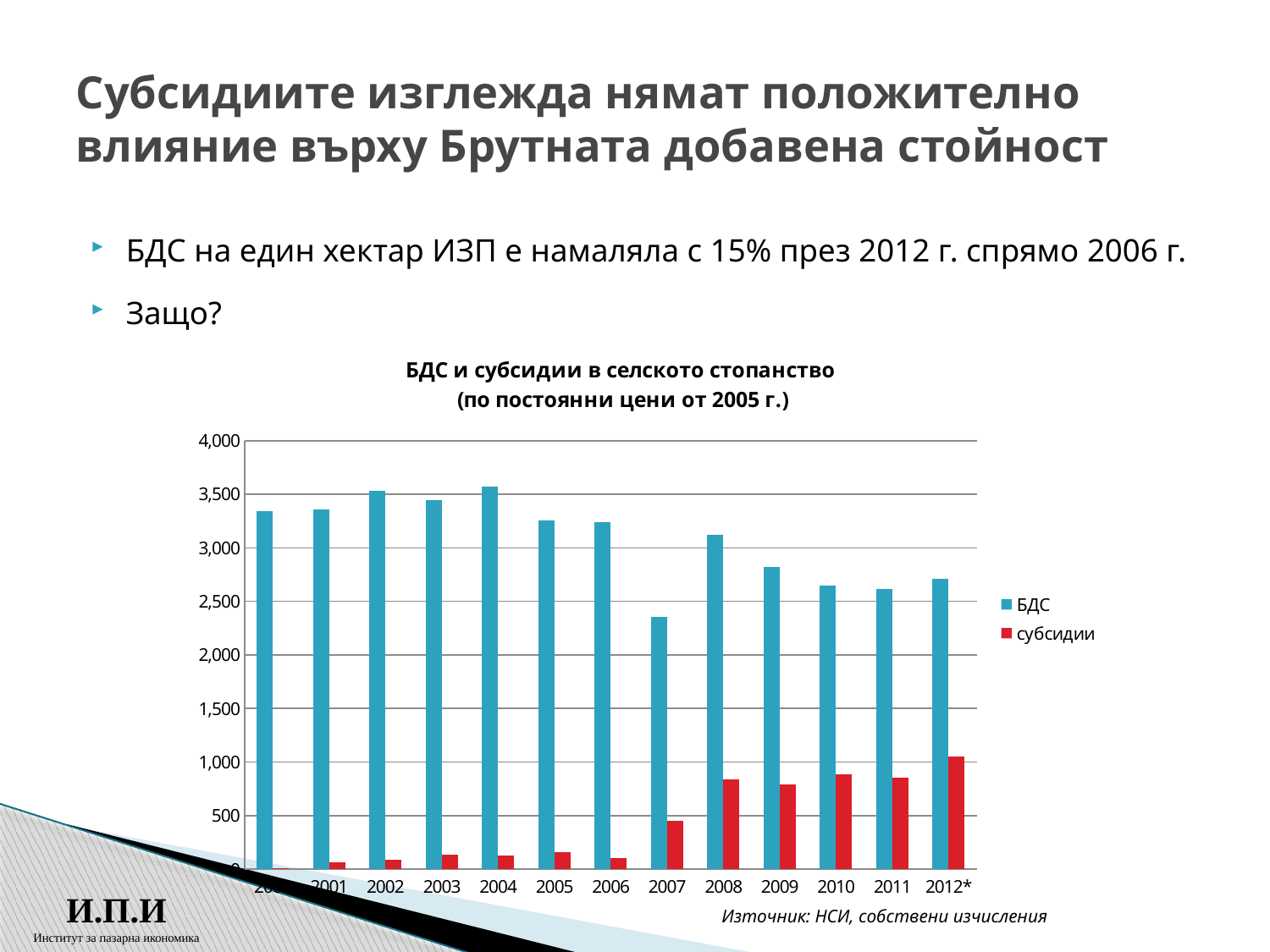
Is the БДС value for 2008 greater or less than 3,000? greater Which is larger, the БДС value for 2006 or for 2007? 2006 What kind of chart is shown on the slide? bar chart What is the title of the chart? БДС и субсидии в селското стопанство (по постоянни цени от 2005 г.) Do the субсидии values generally rise or fall from 2000 to 2012*? rise In which year is the субсидии value highest? 2012* Is the БДС value for 2007 greater or less than 2,500? less How many series does the legend list? 2 In which year is the БДС value lowest? 2007 Which series does the red colour represent in the legend? субсидии